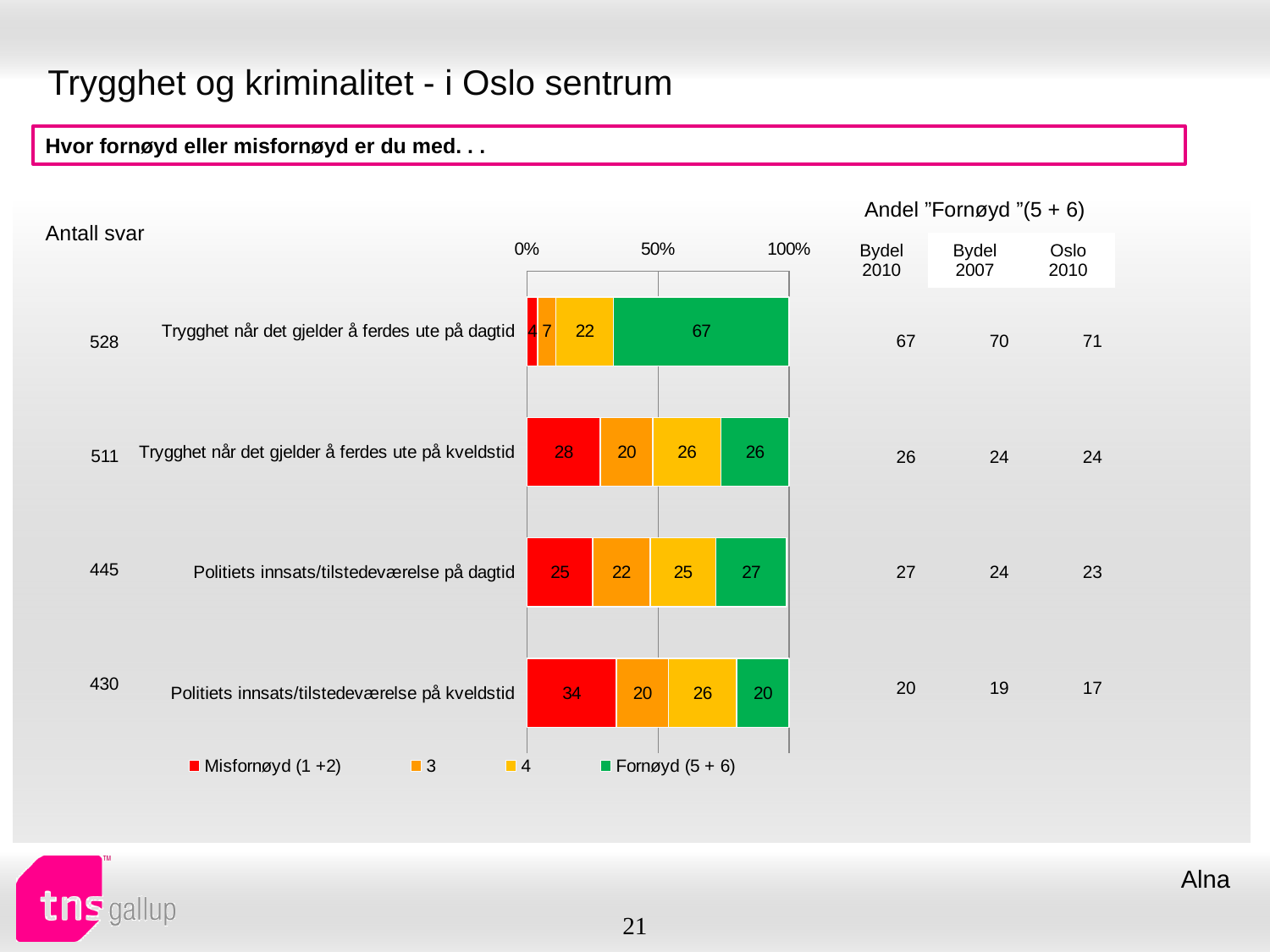
What is the difference between the "Misfornøyd (1 +2)" values for "Politiets innsats/tilstedeværelse på kveldstid" and "Politiets innsats/tilstedeværelse på dagtid"? 9 What is the value of "Fornøyd (5 + 6)" for "Trygghet når det gjelder å ferdes ute på dagtid"? 67 Which category has the lowest "Misfornøyd (1 +2)" value? Trygghet når det gjelder å ferdes ute på dagtid Which category has the highest "Fornøyd (5 + 6)" value? Trygghet når det gjelder å ferdes ute på dagtid What is the value of series "3" for "Trygghet når det gjelder å ferdes ute på kveldstid"? 20 What kind of chart is shown on the slide? Stacked bar chart What is the value of "Misfornøyd (1 +2)" for "Politiets innsats/tilstedeværelse på kveldstid"? 34 What is the value of series "4" for "Politiets innsats/tilstedeværelse på dagtid"? 25 Which is larger: the "Fornøyd (5 + 6)" value for "Trygghet når det gjelder å ferdes ute på kveldstid" or for "Politiets innsats/tilstedeværelse på kveldstid"? Trygghet når det gjelder å ferdes ute på kveldstid What is the total of the stacked bar for "Politiets innsats/tilstedeværelse på dagtid"? 99 How many categories are shown in the chart? 4 How many series does the legend list? 4